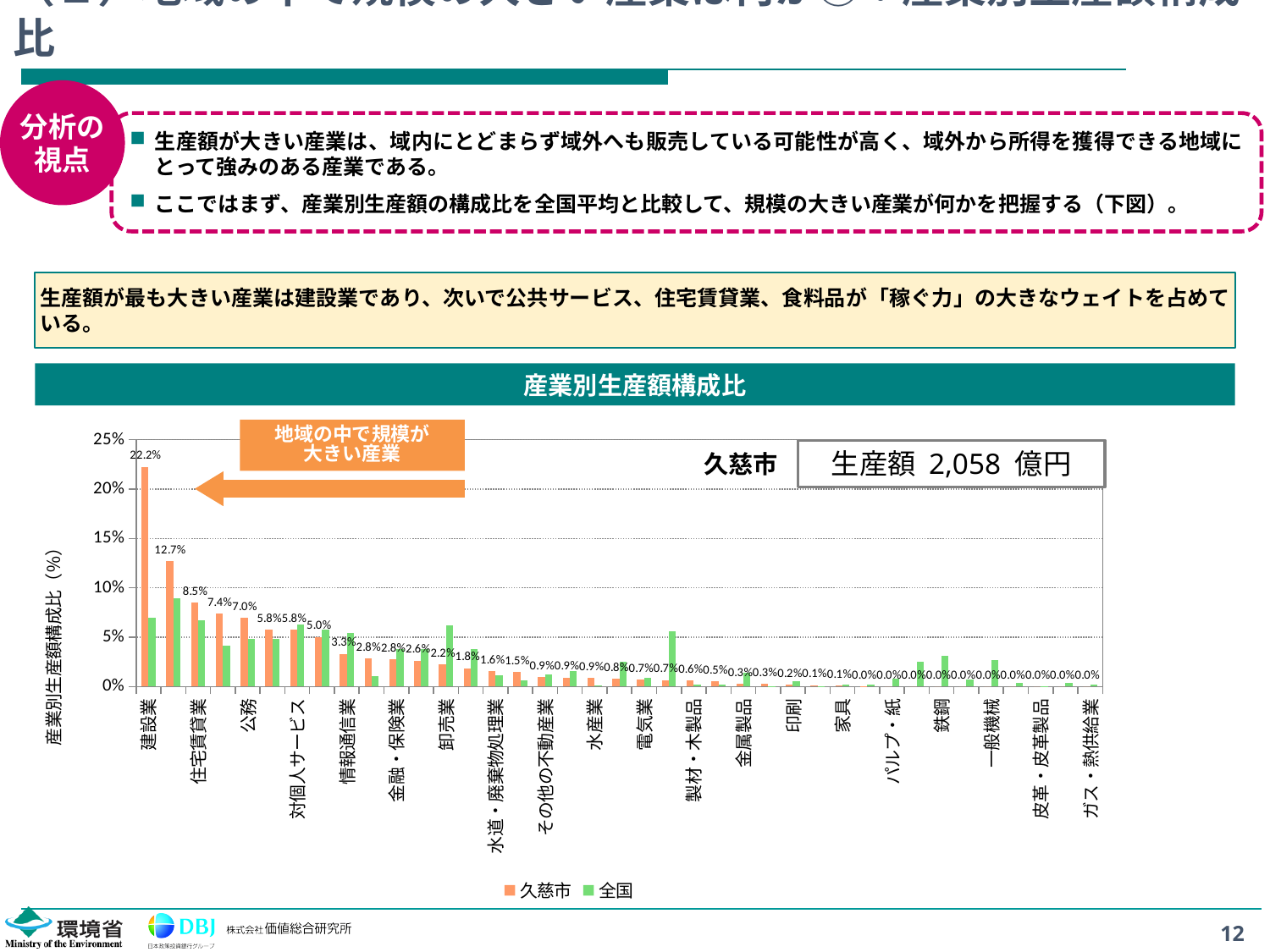
Is the 全国 value for 建設業 greater or less than 10%? less What kind of chart is shown on the slide? bar chart What is the 久慈市 value for 建設業 in the 産業別生産額構成比 chart? 22.2% What is the difference between the 久慈市 values for 建設業 and 住宅賃貸業? 13.7% How many series does the legend list? 2 What is the 久慈市 value for 公務? 7.0% What is the 久慈市 value for 住宅賃貸業? 8.5% Which is larger for 久慈市: 建設業 or 公務? 建設業 Do the 久慈市 values generally rise or fall from left to right along the x axis? fall What is the 久慈市 value for 情報通信業? 3.3% Which industry has the highest 久慈市 share in the chart? 建設業 What is the 久慈市 value for 卸売業? 2.2%